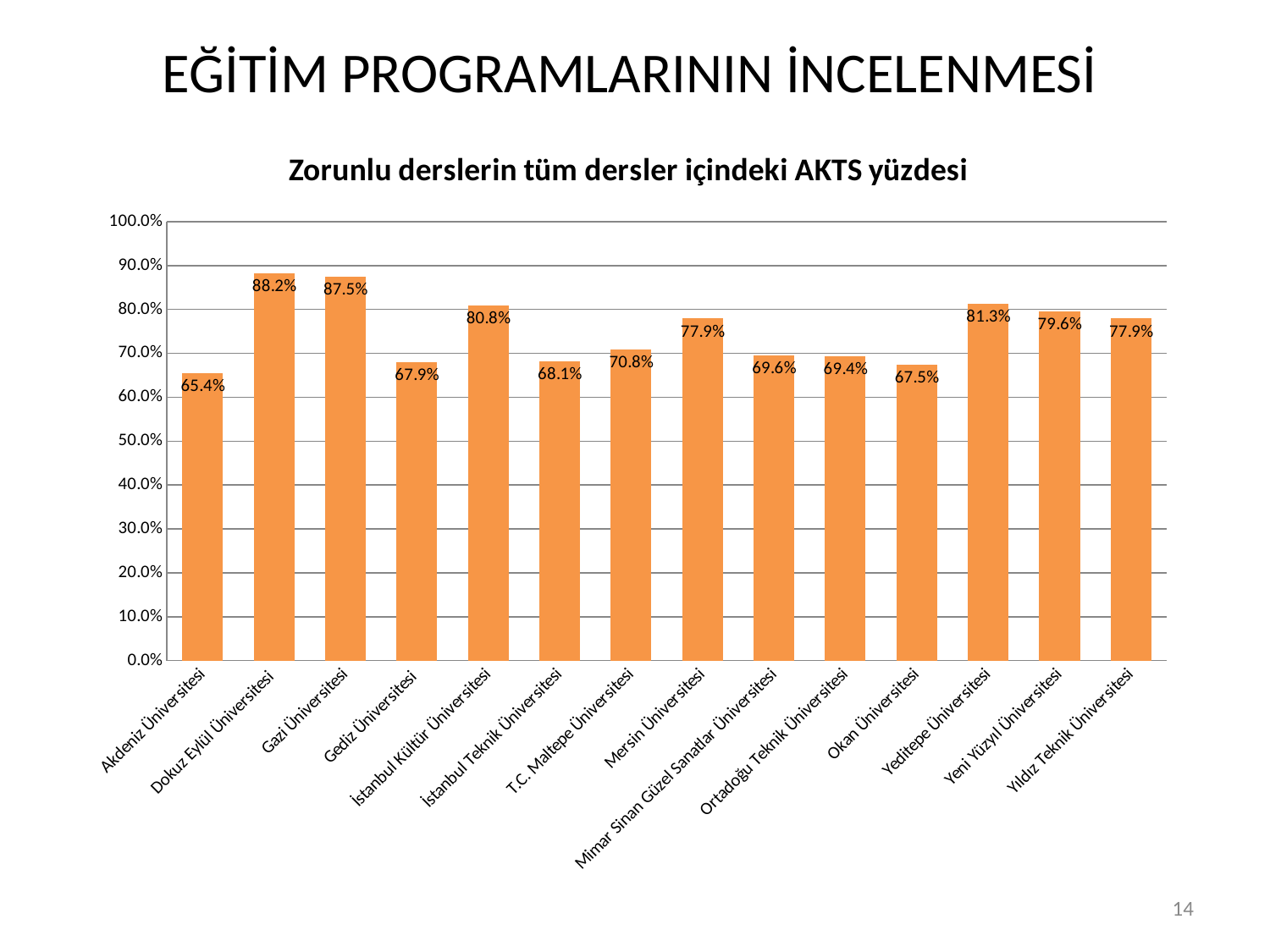
How many universities are shown on the chart? 14 Which university has the highest value? Dokuz Eylül Üniversitesi What is the difference between the values for T.C. Maltepe Üniversitesi and İstanbul Teknik Üniversitesi? 2.7% What is the value for İstanbul Kültür Üniversitesi? 80.8% What is the difference between the values for Gazi Üniversitesi and Gediz Üniversitesi? 19.6% What is the title of the chart? Zorunlu derslerin tüm dersler içindeki AKTS yüzdesi Which university has the lowest value? Akdeniz Üniversitesi What is the value for Okan Üniversitesi? 67.5% What is the value for Dokuz Eylül Üniversitesi? 88.2% What kind of chart is shown on the slide? bar chart Which is larger, the value for Yeditepe Üniversitesi or the value for Yeni Yüzyıl Üniversitesi? Yeditepe Üniversitesi Is the value for Mersin Üniversitesi greater or less than 70.0%? greater